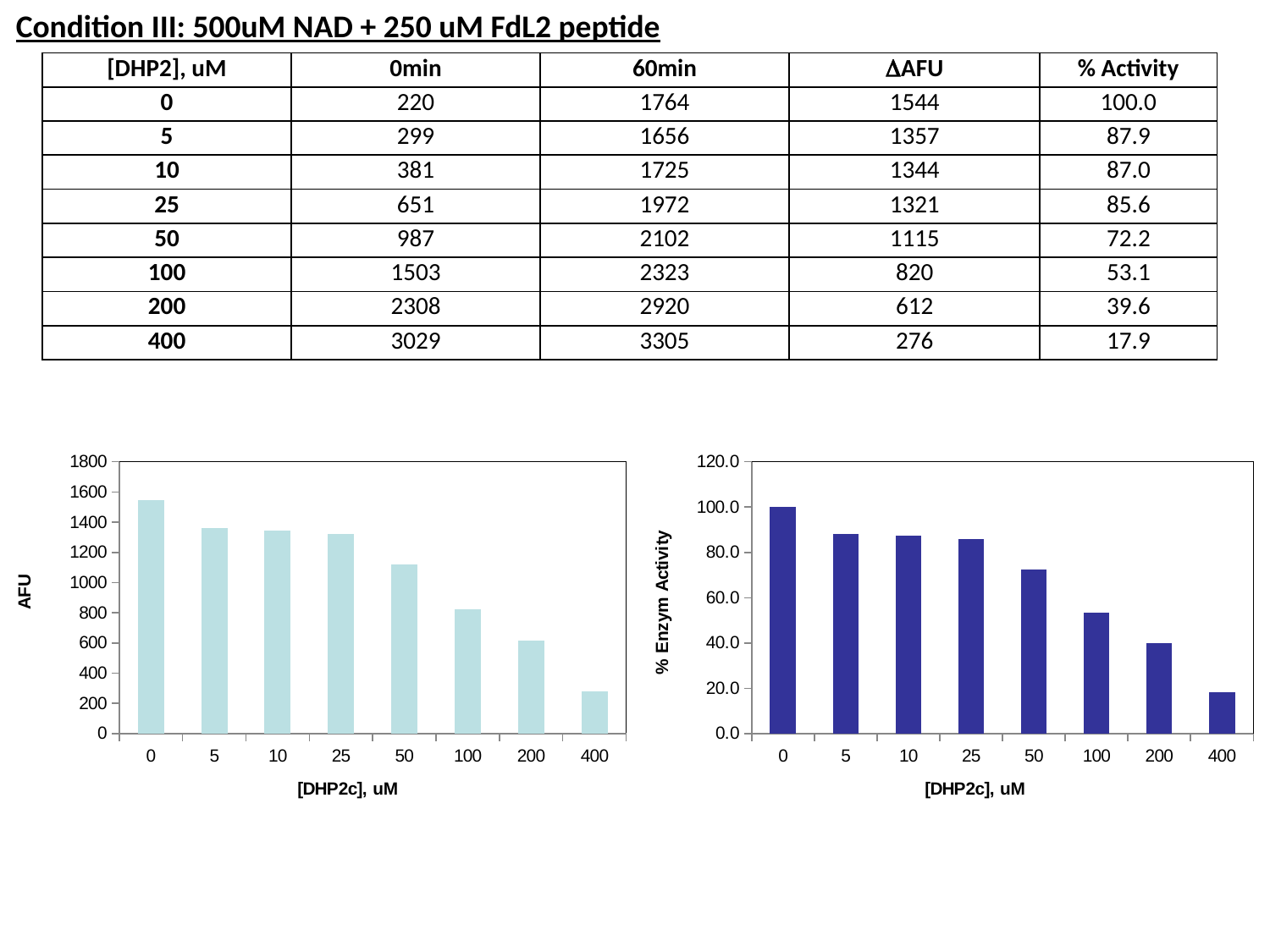
In the right chart (% Enzym Activity), is the value for [DHP2c] = 100 uM greater or less than 60.0? less In the left chart (AFU), which is larger, the bar for 100 uM or the bar for 200 uM? 100 uM In the left chart (AFU), which [DHP2c] concentration has the lowest bar? 400 In the right chart (% Enzym Activity), is the value for [DHP2c] = 400 uM greater or less than 20.0? less In the left chart (AFU), which [DHP2c] concentration has the highest bar? 0 What kind of chart is the left chart with the AFU y-axis? bar chart In the right chart (% Enzym Activity), what is the value for [DHP2c] = 0 uM? 100.0 What is the y-axis title of the right chart? % Enzym Activity In the left chart (AFU), is the value for [DHP2c] = 50 uM greater or less than 1000? greater What is the x-axis title of the left chart? [DHP2c], uM In the right chart (% Enzym Activity), do the values rise or fall as [DHP2c] increases along the x axis? fall How many concentration categories are shown on the x axis of the right chart (% Enzym Activity)? 8